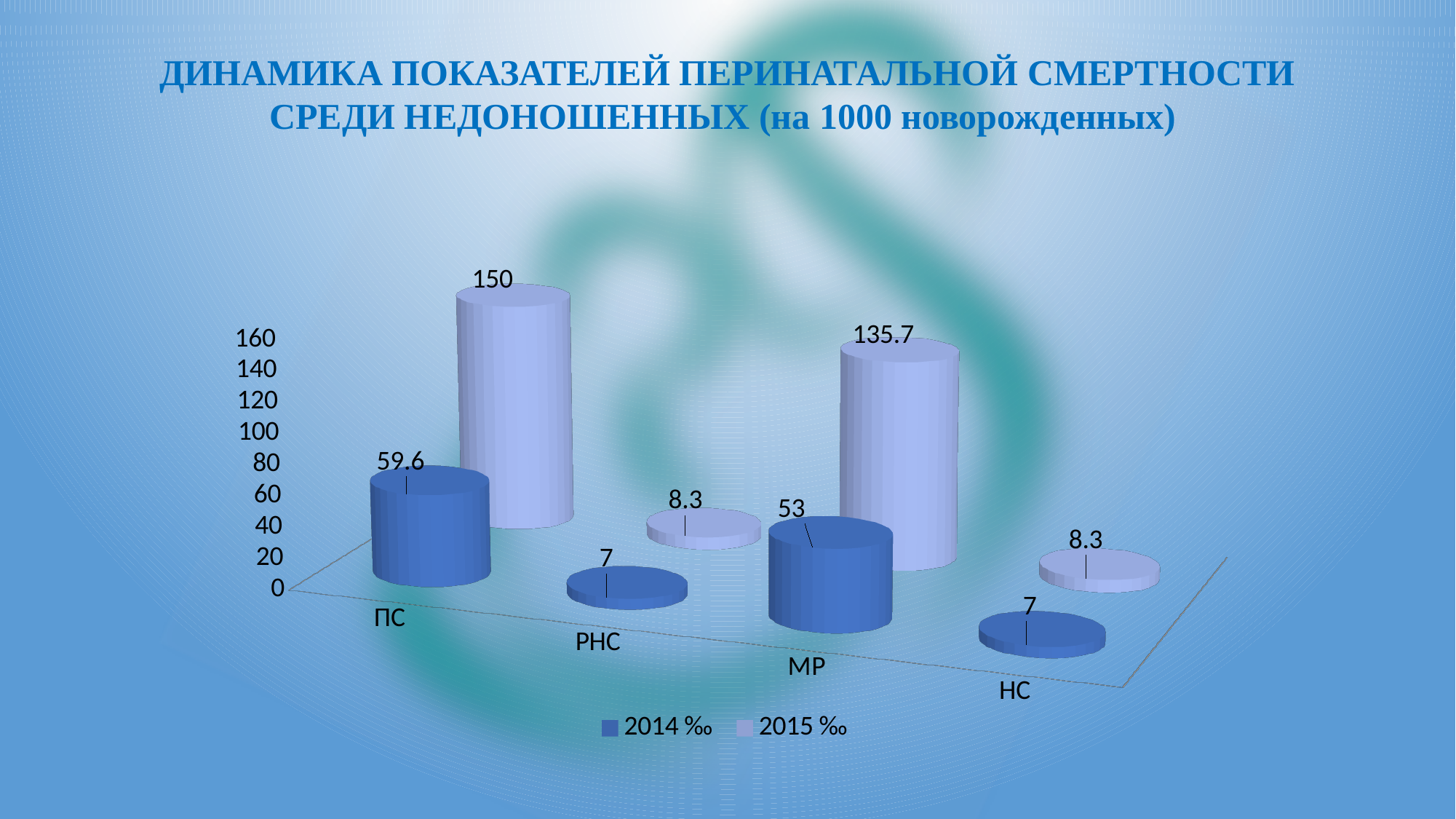
What is the value for НС in the 2015 ‰ series? 8.3 What is the value for ПС in the 2014 ‰ series? 59.6 Which is larger for МР: the 2014 ‰ value or the 2015 ‰ value? 2015 ‰ How many series does the legend list? 2 Which category has the highest value in the 2015 ‰ series? ПС What is the difference between the 2015 ‰ and 2014 ‰ values for ПС? 90.4 What is the value for РНС in the 2014 ‰ series? 7 What kind of chart is shown on the slide? Bar chart What is the value for ПС in the 2015 ‰ series? 150 What is the value for МР in the 2015 ‰ series? 135.7 Which category has the lowest value in the 2014 ‰ series? РНС and НС (both 7) How many categories are shown on the x axis? 4